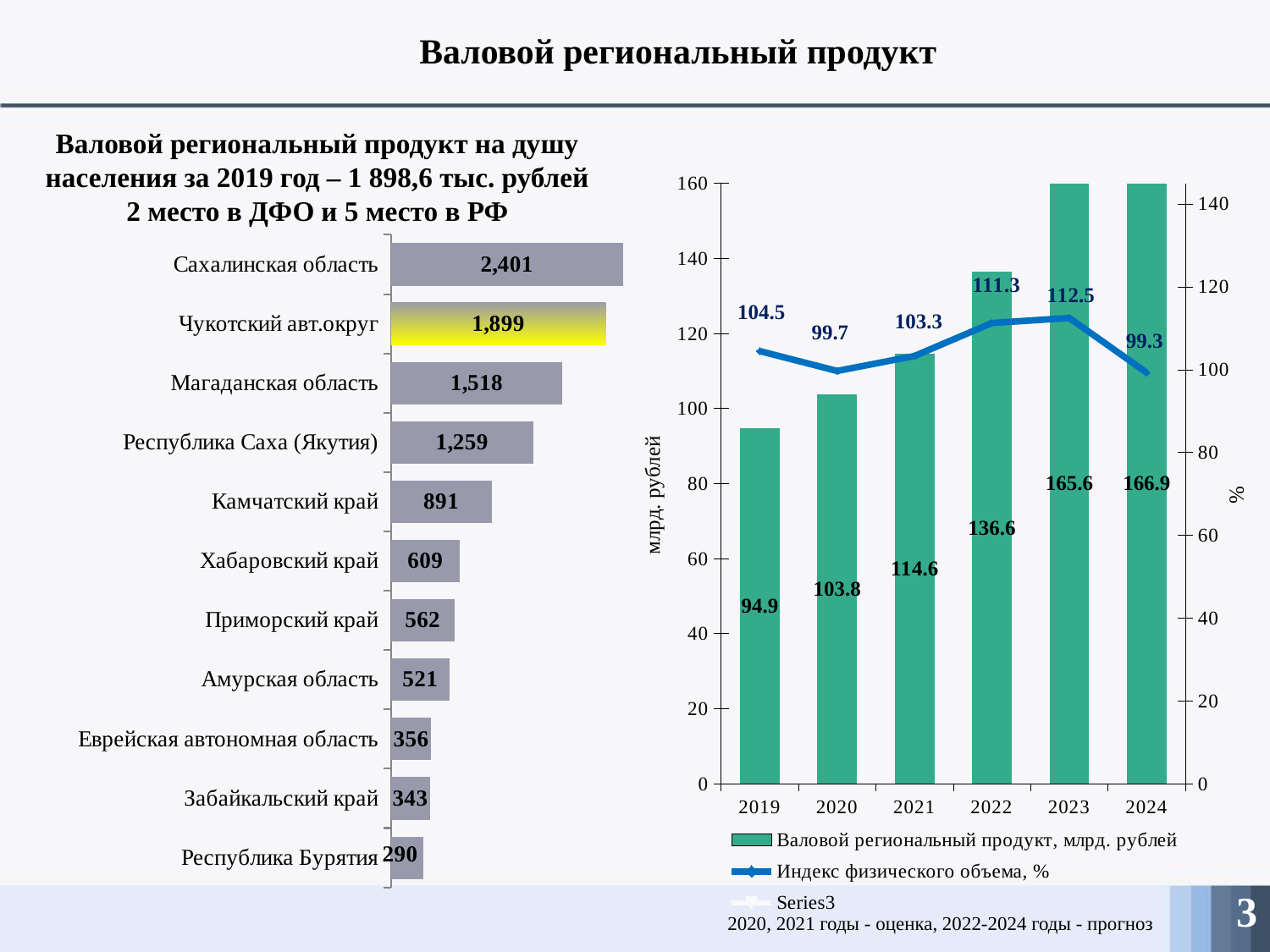
What type of chart is the left chart of gross regional product per capita? Bar chart In the left chart of gross regional product per capita, which is larger: Хабаровский край or Приморский край? Хабаровский край In the right chart, what is the value of Индекс физического объема, % for 2020? 99.7 In the right chart, what is the difference in Валовой региональный продукт, млрд. рублей between 2024 and 2019? 72.0 In the left chart of gross regional product per capita, which region has the lowest value? Республика Бурятия In the left chart of gross regional product per capita, how many regions are shown? 11 In the left chart of gross regional product per capita, what is the value for Магаданская область? 1,518 In the left chart of gross regional product per capita, which region has the highest value? Сахалинская область In the right chart, does Валовой региональный продукт, млрд. рублей rise or fall from 2019 to 2024? Rise In the left chart of gross regional product per capita, what is the difference between Сахалинская область and Чукотский авт.округ? 502 In the right chart, in which year is Индекс физического объема, % highest? 2023 In the right chart, what is the value of Валовой региональный продукт, млрд. рублей for 2022? 136.6